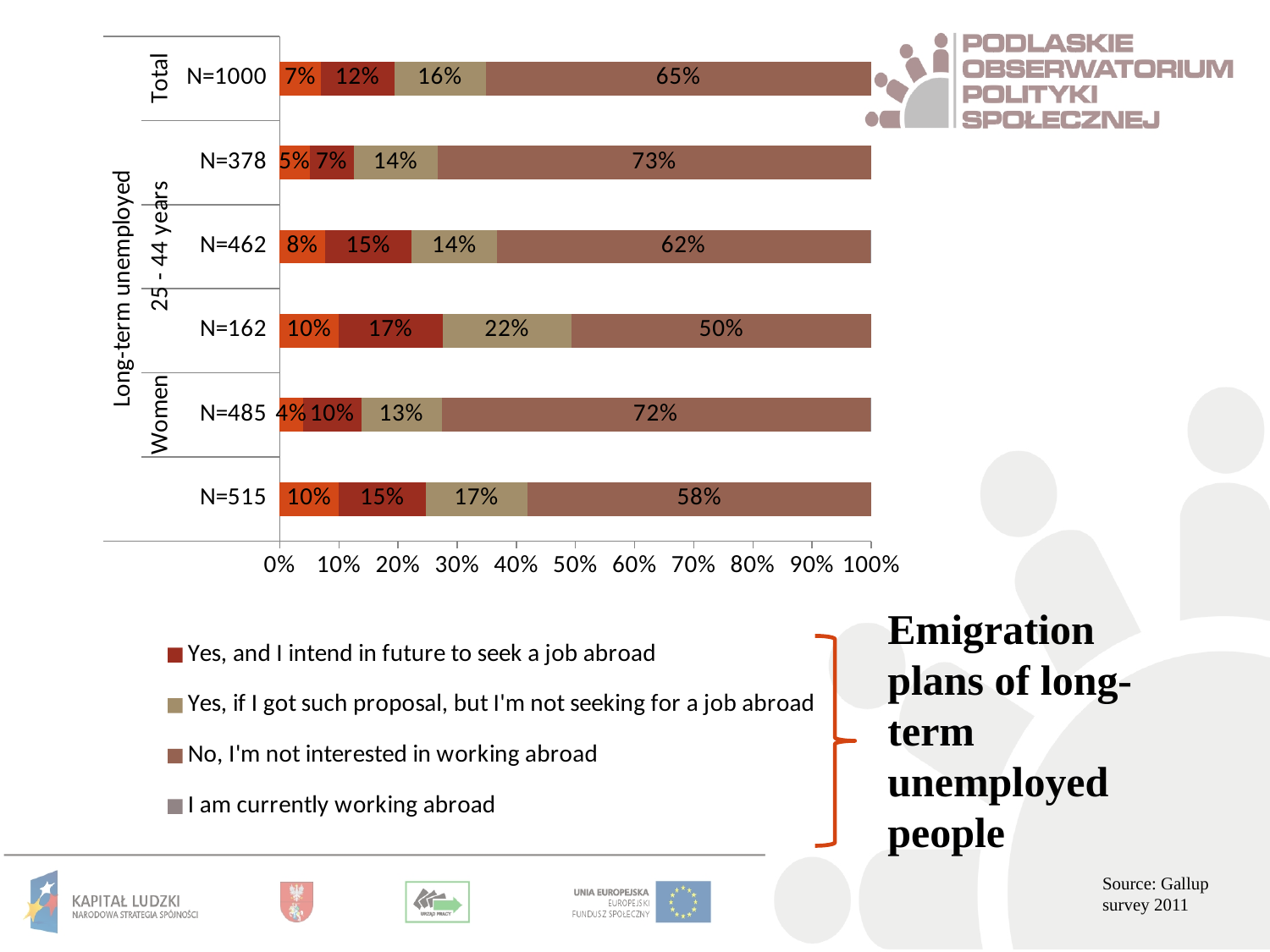
How many entries does the chart legend list? 4 Which bar has the lowest value for the 'No, I'm not interested in working abroad' segment? N=162 What source is cited for the chart data? Gallup survey 2011 What kind of chart is shown on the slide? Stacked bar chart What is the value of the first (leftmost) segment of the N=162 bar? 10% Which bar has the highest value for the 'No, I'm not interested in working abroad' segment? N=378 Which has a larger 'No, I'm not interested in working abroad' value: Women (N=485) or N=515? Women (N=485) What is the title given for the chart on the slide? Emigration plans of long-term unemployed people How many bars (rows) are plotted in the chart? 6 What is the value of the 'No, I'm not interested in working abroad' segment for the Total (N=1000) bar? 65% What is the value of the 'No, I'm not interested in working abroad' segment for the Women (N=485) bar? 72% What is the difference between the 'No, I'm not interested in working abroad' values for Total (N=1000) and N=162? 15 percentage points